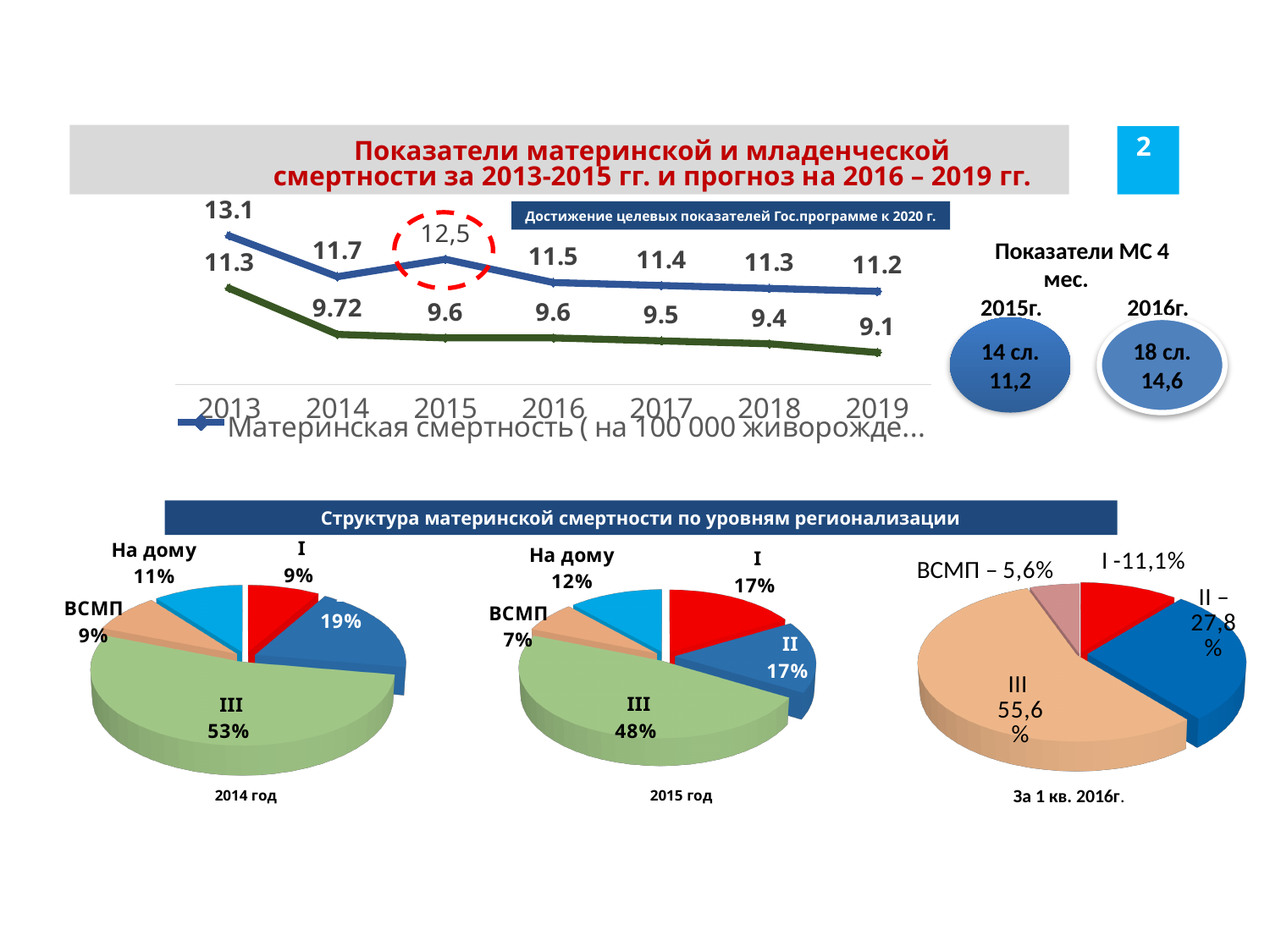
In the top line chart, what is the value of the lower (green) line for 2014? 9.72 In the 2014 год pie chart, what share does level III have? 53% In the За 1 кв. 2016г. pie chart, what share does level II have? 27,8% In the top line chart, what is the difference between the Материнская смертность values for 2013 and 2014? 1.4 In the top line chart, what is the value of the Материнская смертность series for 2015? 12,5 In the top line chart, does the lower (green) line rise or fall from 2013 to 2019? fall What kind of chart is used for the Структура материнской смертности по уровням регионализации section? pie chart In the top line chart, how many years are shown on the x axis? 7 In the top line chart, what is the value of the Материнская смертность series for 2019? 11.2 In the top line chart, in which year is the Материнская смертность series highest? 2013 In the 2015 год pie chart, which category has the smallest share? ВСМП In the 2015 год pie chart, which is larger: На дому or ВСМП? На дому